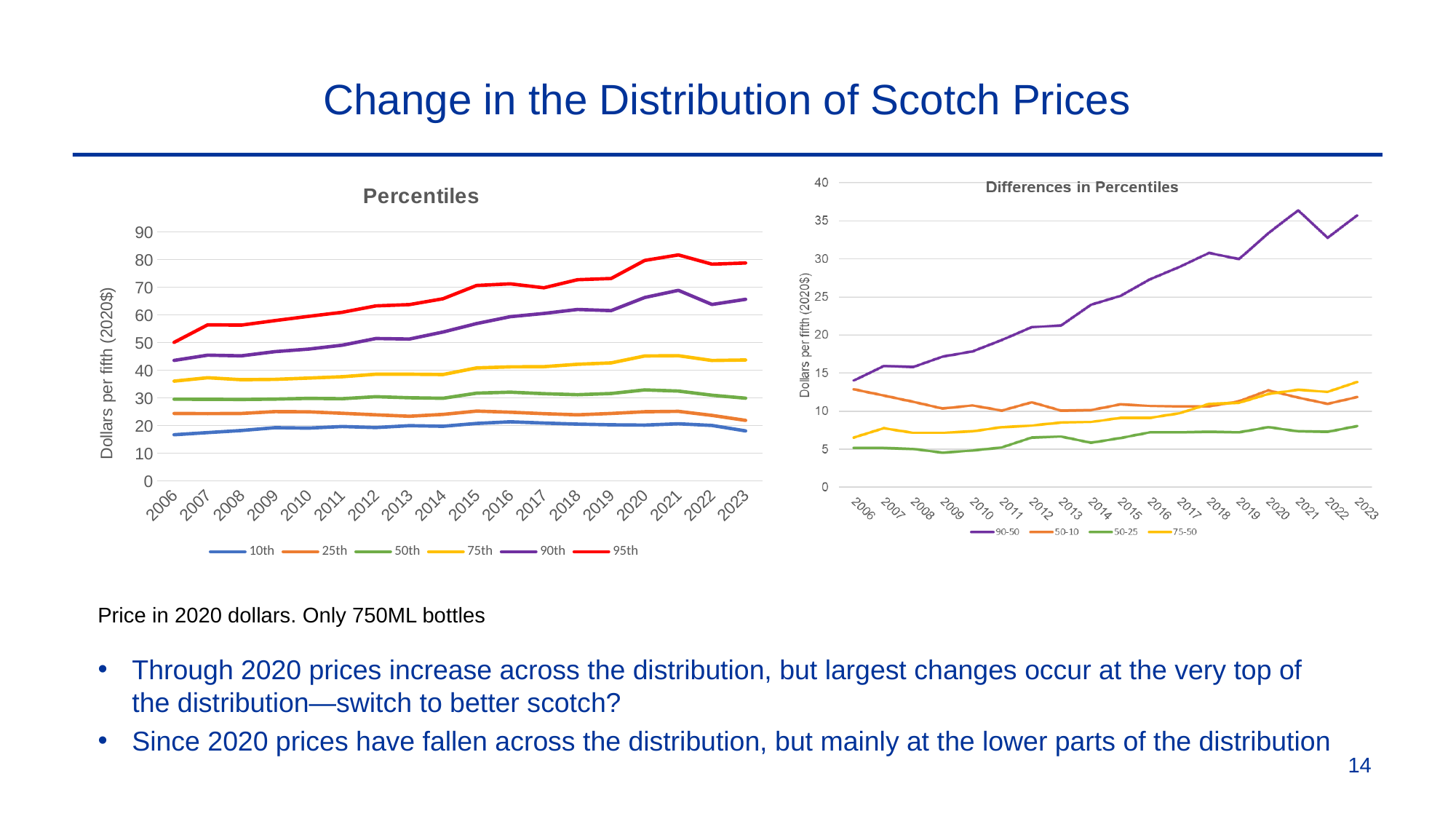
What kind of chart is the "Percentiles" chart on the left? Line chart In the "Percentiles" chart, how many series does the legend list? 6 In the "Differences in Percentiles" chart, does the 90-50 series rise or fall from 2006 to 2023? Rises In the "Differences in Percentiles" chart, how many series does the legend list? 4 In the "Differences in Percentiles" chart, which series has the highest values? 90-50 In the "Percentiles" chart, which series has the highest values across the years? 95th In the "Differences in Percentiles" chart, is the value for 90-50 in 2021 greater or less than 30? greater What is the y-axis label of the "Percentiles" chart? Dollars per fifth (2020$) In the "Percentiles" chart, how many years are shown on the x axis? 18 In the "Percentiles" chart, is the value for the 10th percentile in 2023 greater or less than 20? less In the "Percentiles" chart, which series has the lowest values across the years? 10th In the "Percentiles" chart, is the value for the 90th percentile in 2023 greater or less than 60? greater